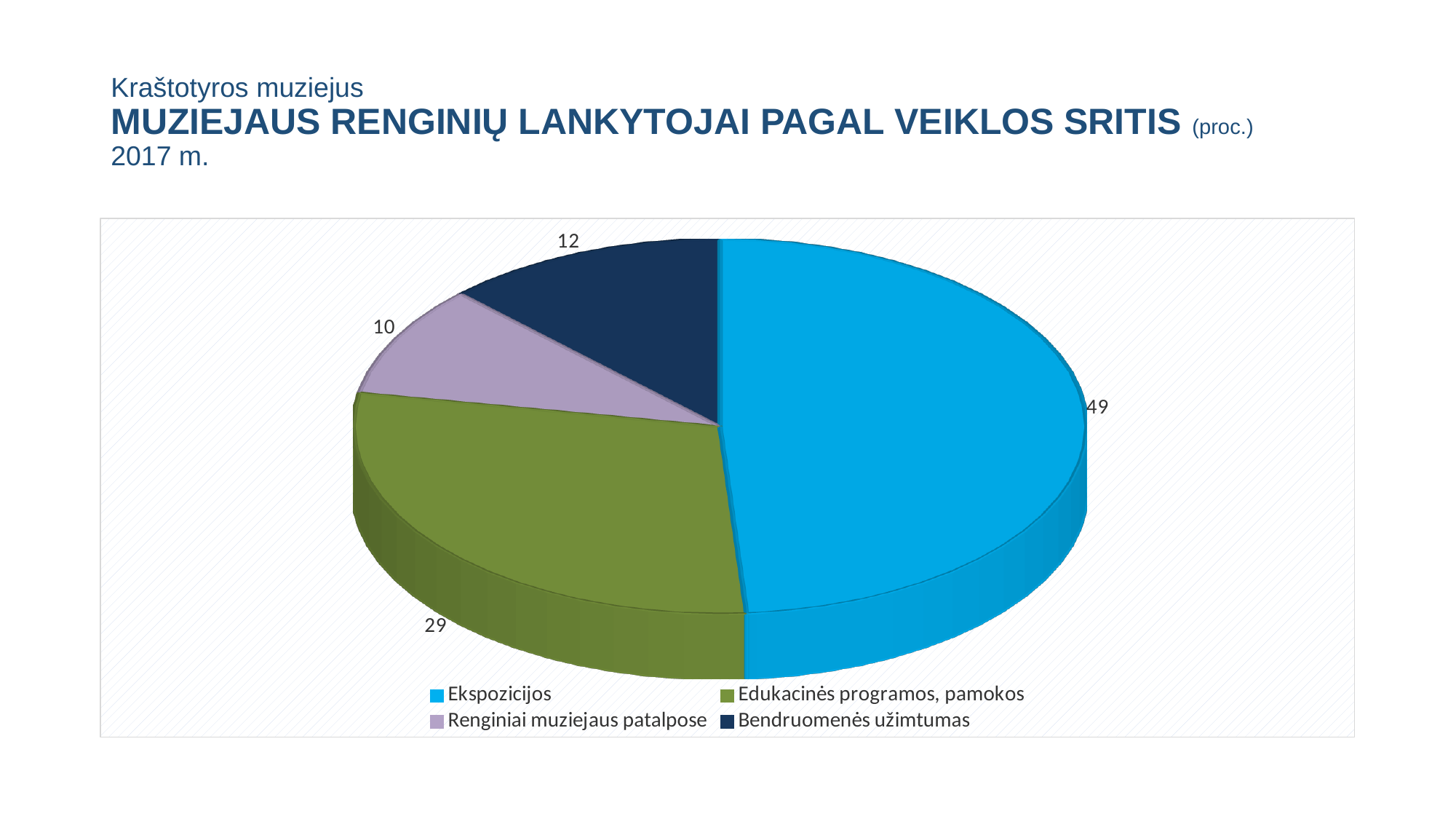
What is the value for Edukacinės programos, pamokos? 29 Which is larger, Bendruomenės užimtumas or Renginiai muziejaus patalpose? Bendruomenės užimtumas Which category has the largest slice? Ekspozicijos What is the difference between the values for Ekspozicijos and Edukacinės programos, pamokos? 20 What is the value for Bendruomenės užimtumas? 12 What is the total of all the slice values shown? 100 How many categories does the pie chart show? 4 Which colour represents Edukacinės programos, pamokos in the legend? green What is the value for Renginiai muziejaus patalpose? 10 Which category has the smallest slice? Renginiai muziejaus patalpose What is the value for Ekspozicijos? 49 What kind of chart is shown on the slide? pie chart